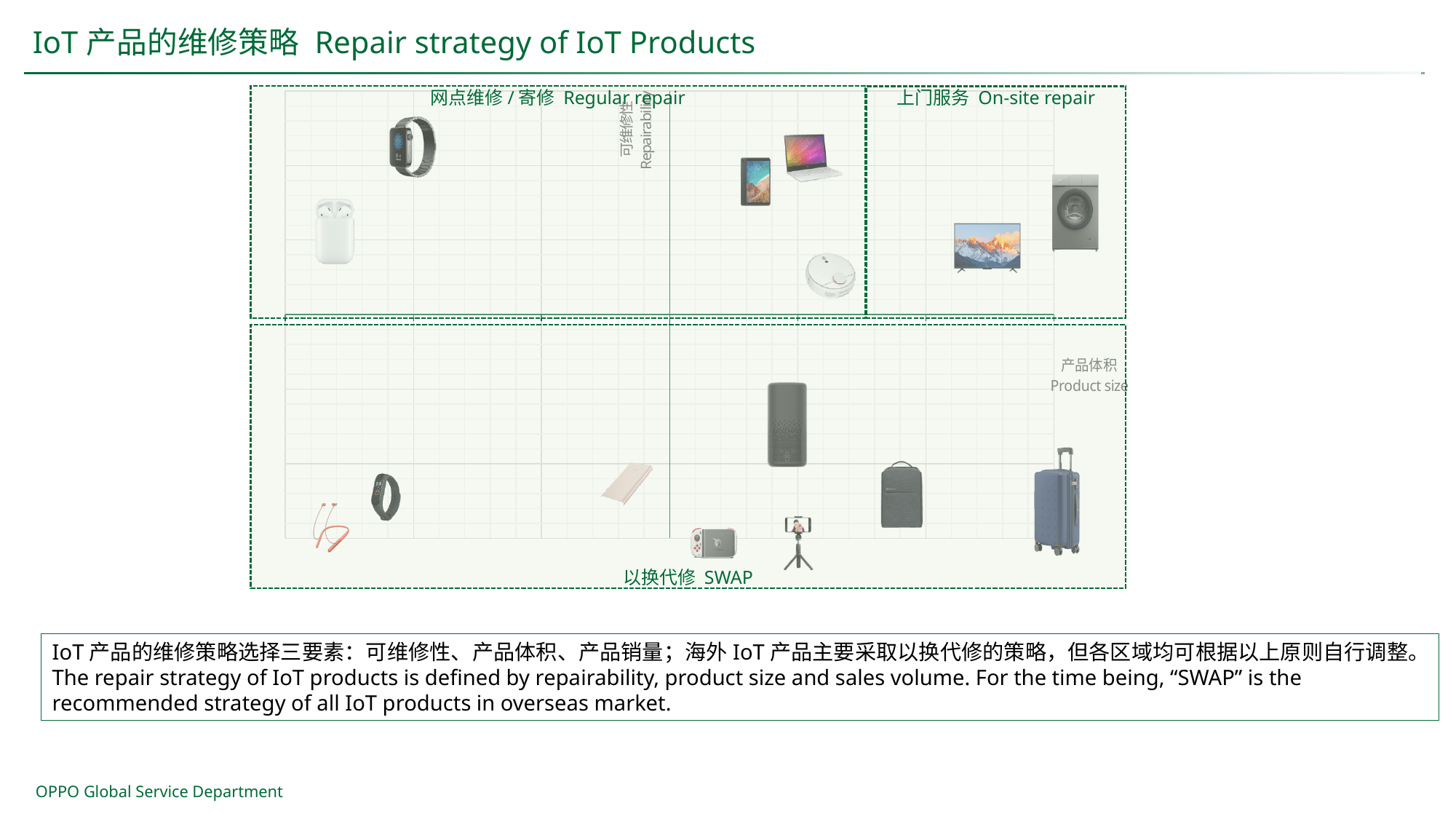
Which region is positioned higher on the repairability axis: SWAP or Regular repair? Regular repair Which repair strategy region contains the television? On-site repair What does the vertical axis of the matrix represent? Repairability (可维修性) Which repair strategy region contains the smartwatch? Regular repair Which region is positioned further right on the product size axis: Regular repair or On-site repair? On-site repair Which repair strategy region contains the laptop? Regular repair Which repair strategy region contains the backpack? SWAP Which repair strategy region contains the suitcase? SWAP Which repair strategy region contains the washing machine? On-site repair How many repair strategy regions are labelled in the matrix? 3 What does the horizontal axis of the matrix represent? Product size (产品体积)